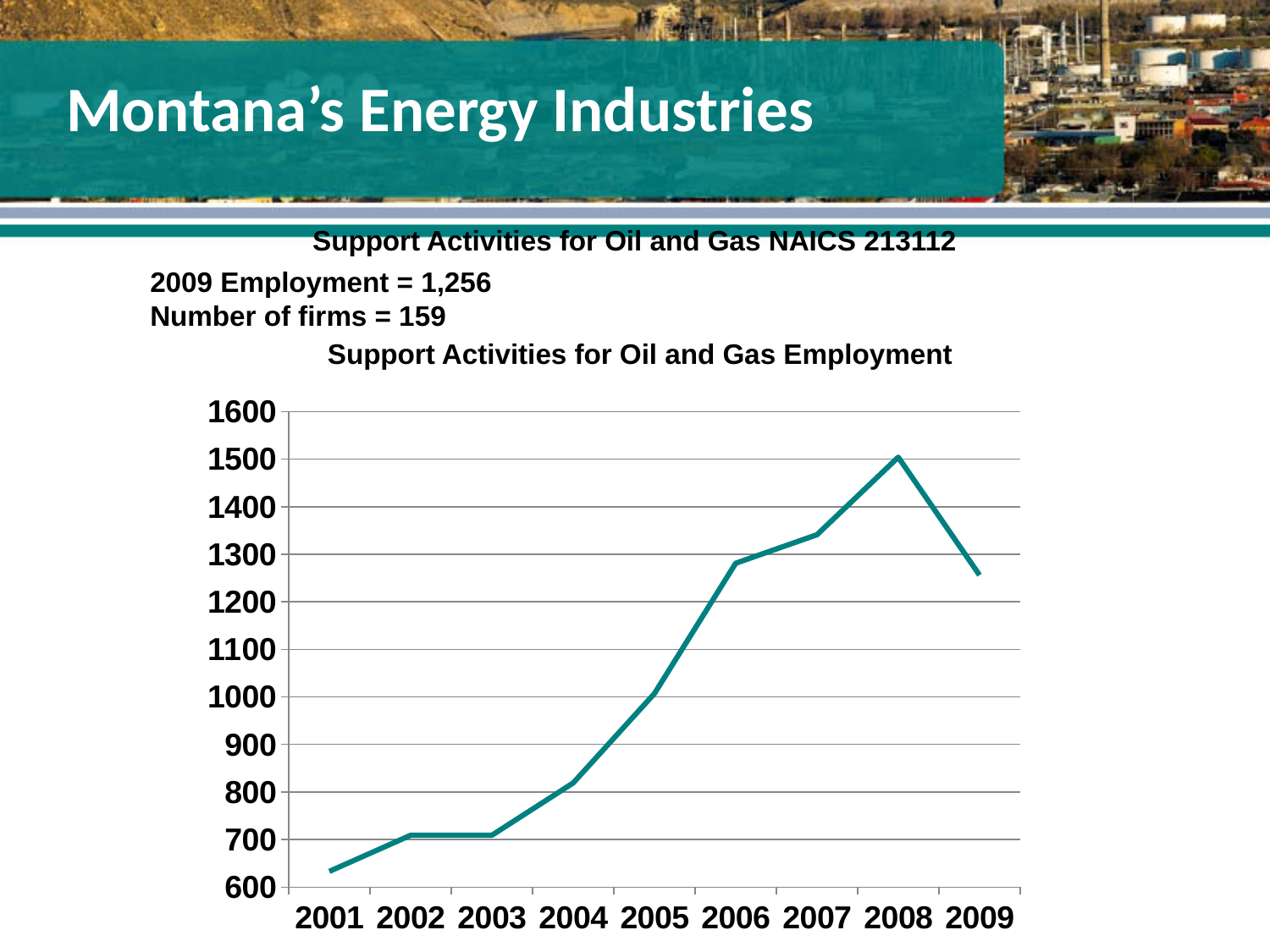
How many years are plotted on the x axis of the chart? 9 What kind of chart is shown on the slide? line chart Which year has higher employment, 2004 or 2006? 2006 Is the employment value for 2006 greater or less than 1200? greater Is the employment value for 2008 greater or less than 1400? greater Does employment rise or fall from 2001 to 2008? rise What is the 2009 employment value for Support Activities for Oil and Gas? 1,256 What is the title of the chart? Support Activities for Oil and Gas Employment Is the employment value for 2001 greater or less than 700? less In which year is employment highest in the chart? 2008 In which year is employment lowest in the chart? 2001